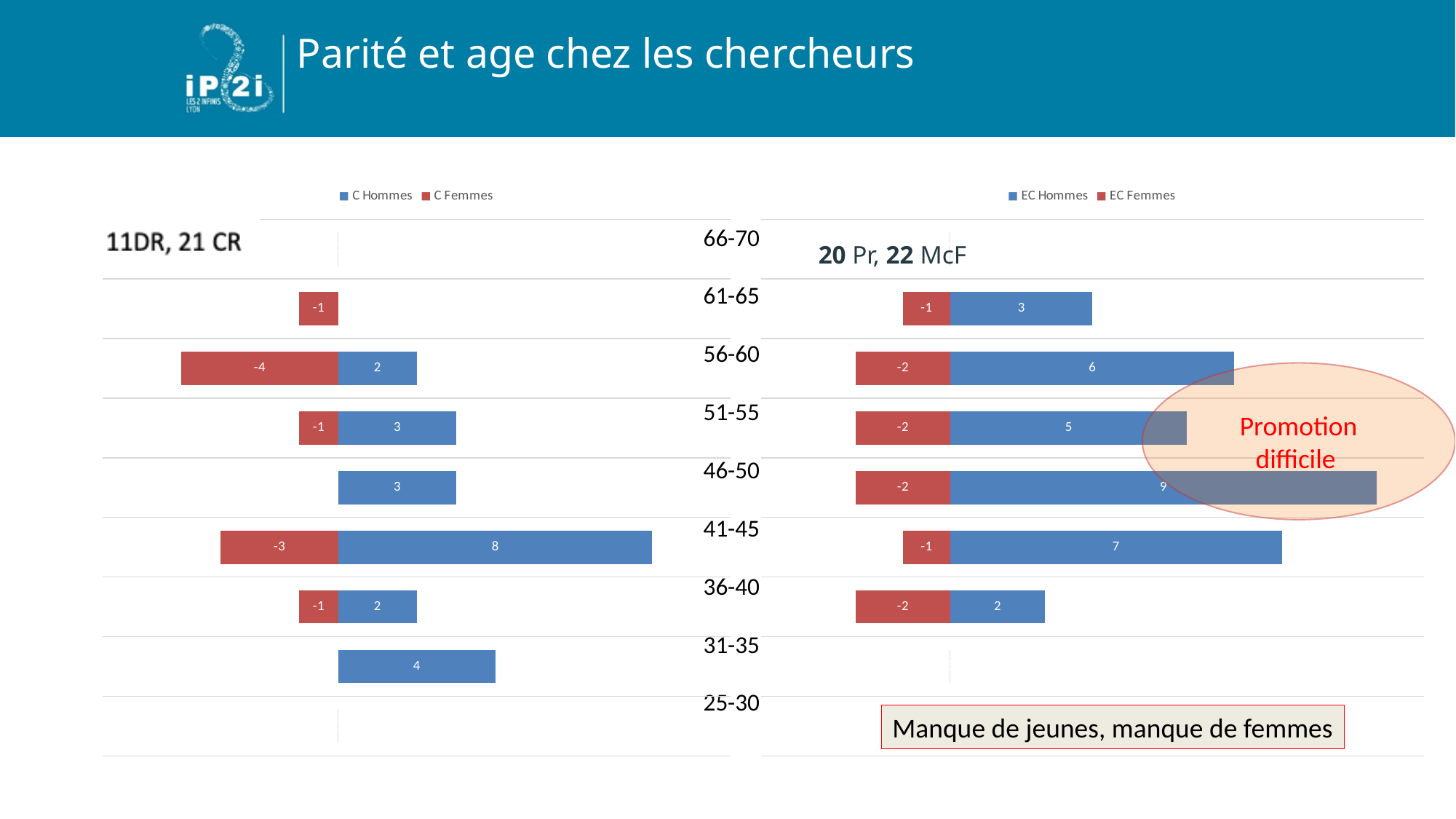
In the right chart (EC Hommes / EC Femmes), which age band has the lowest EC Hommes value among the bands with a bar? 36-40 How many series does the legend of the right chart (EC Hommes / EC Femmes) list? 2 In the right chart (EC Hommes / EC Femmes), what is the value for EC Hommes in the 46-50 age band? 9 In the left chart (C Hommes / C Femmes), what is the value for C Hommes in the 41-45 age band? 8 What type of chart is the left chart (C Hommes / C Femmes)? Bar chart In the left chart (C Hommes / C Femmes), which age band has the highest C Hommes value? 41-45 In the right chart (EC Hommes / EC Femmes), what is the difference between the EC Hommes values for 46-50 and 41-45? 2 In the left chart (C Hommes / C Femmes), which is larger: the C Hommes value for 31-35 or for 36-40? 31-35 What are the two legend entries of the left chart? C Hommes, C Femmes In the right chart (EC Hommes / EC Femmes), which age band has the highest EC Hommes value? 46-50 In the right chart (EC Hommes / EC Femmes), what is the value for EC Femmes in the 36-40 age band? -2 In the left chart (C Hommes / C Femmes), what is the value for C Femmes in the 56-60 age band? -4